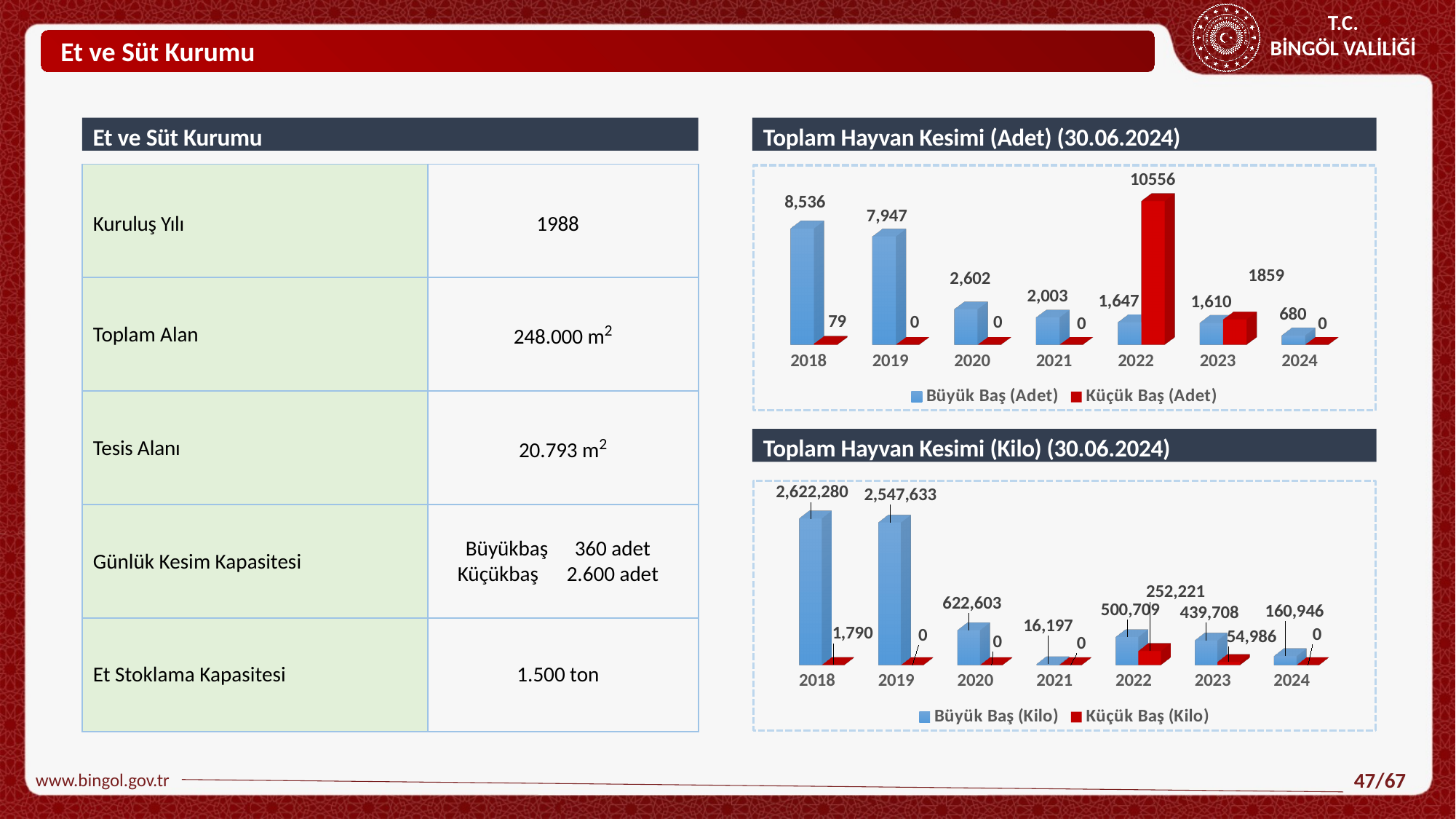
In the 'Toplam Hayvan Kesimi (Adet)' chart, which year has the lowest Büyük Baş (Adet) value? 2024 In the 'Toplam Hayvan Kesimi (Adet)' chart, what is the Büyük Baş (Adet) value for 2018? 8,536 In the 'Toplam Hayvan Kesimi (Adet)' chart, how many years are shown on the x axis? 7 In the 'Toplam Hayvan Kesimi (Adet)' chart, what is the difference between the Büyük Baş (Adet) values for 2018 and 2019? 589 In the 'Toplam Hayvan Kesimi (Kilo)' chart, what is the Büyük Baş (Kilo) value for 2020? 622,603 In the 'Toplam Hayvan Kesimi (Adet)' chart, what is the Küçük Baş (Adet) value for 2022? 10556 In the 'Toplam Hayvan Kesimi (Adet)' chart, which year has the highest Büyük Baş (Adet) value? 2018 In the 'Toplam Hayvan Kesimi (Kilo)' chart, which year has the lowest Büyük Baş (Kilo) value? 2021 In the 'Toplam Hayvan Kesimi (Kilo)' chart, which is larger: the Büyük Baş (Kilo) value for 2022 or for 2023? 2022 In the 'Toplam Hayvan Kesimi (Adet)' chart, how many series does the legend list? 2 What kind of chart is the 'Toplam Hayvan Kesimi (Kilo)' chart? Bar chart In the 'Toplam Hayvan Kesimi (Kilo)' chart, what is the Küçük Baş (Kilo) value for 2023? 54,986